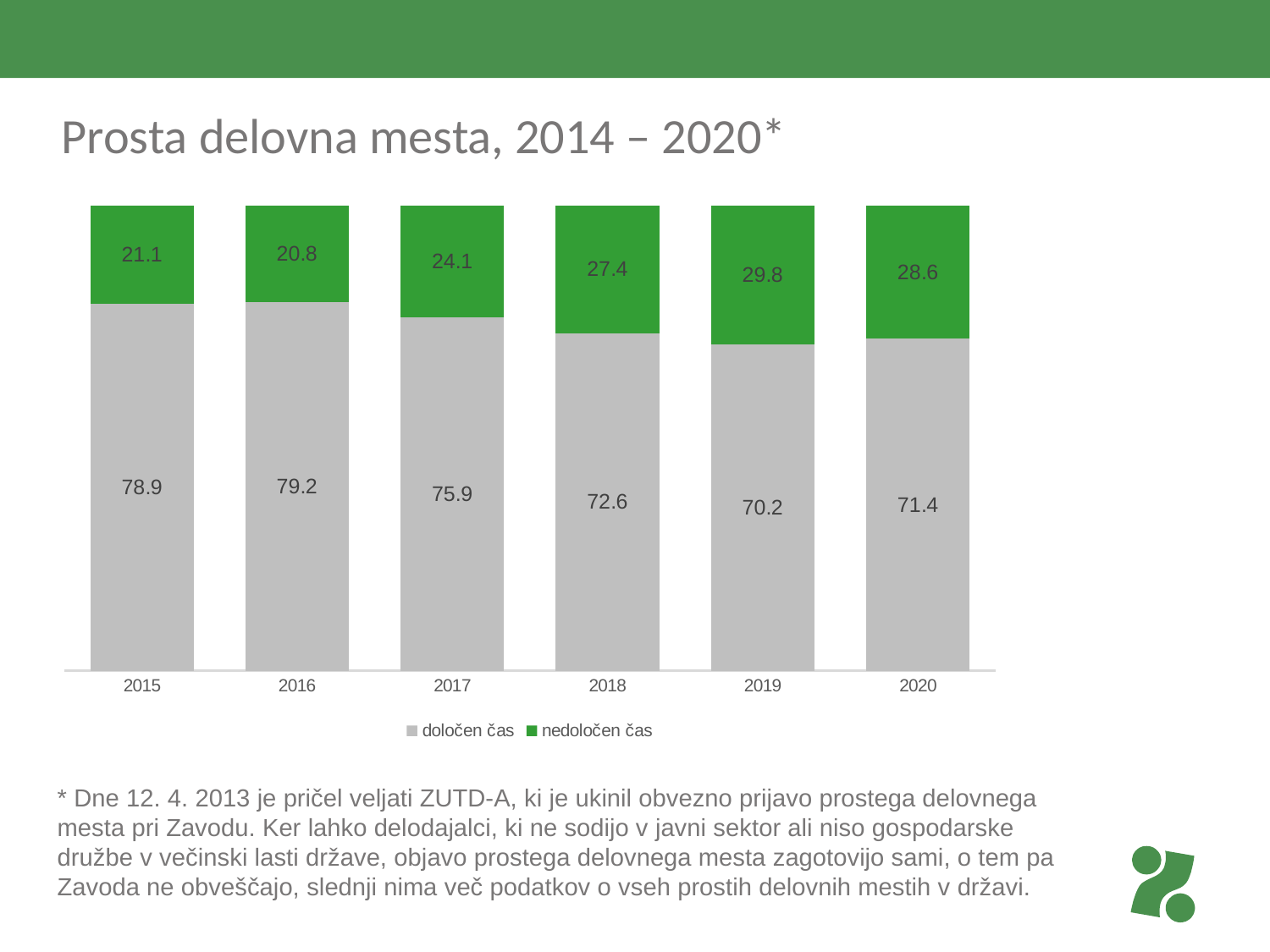
Which year has the highest value for "nedoločen čas"? 2019 Which is larger: the "nedoločen čas" value for 2018 or for 2020? 2020 What is the total of the stacked bar for 2018? 100 Does the "nedoločen čas" value rise or fall from 2016 to 2019? Rise What kind of chart is shown on the slide? Stacked bar chart How many series does the legend list? 2 What is the value for "nedoločen čas" in 2019? 29.8 What is the value for "določen čas" in 2020? 71.4 What is the difference between the "določen čas" values for 2015 and 2019? 8.7 What is the value for "določen čas" in 2017? 75.9 How many years are shown on the x axis? 6 Which year has the lowest value for "določen čas"? 2019